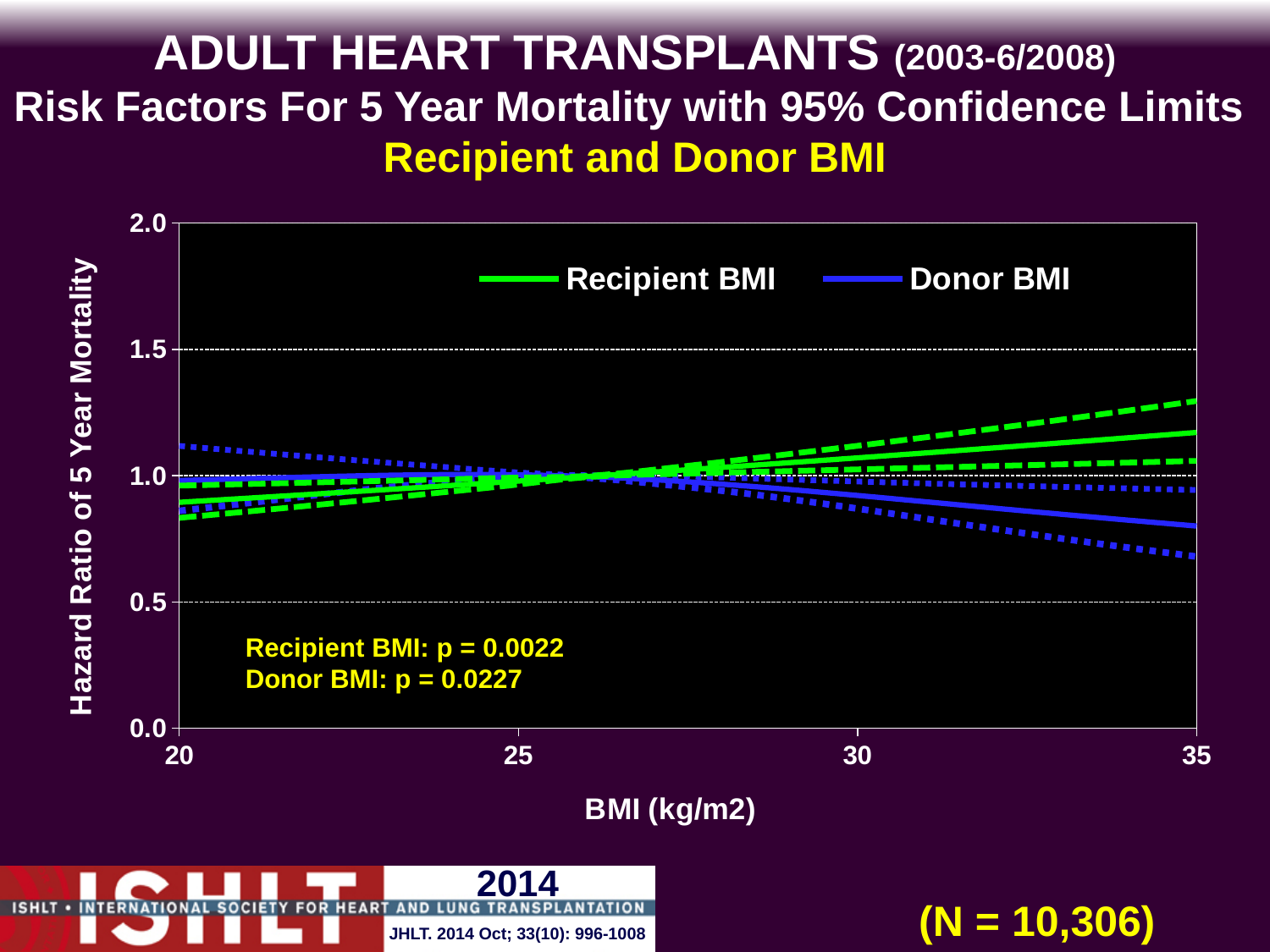
What p-value is shown for Recipient BMI? p = 0.0022 At a BMI of 35, is the lower confidence limit for Donor BMI greater or less than 0.5? greater At a BMI of 35, is the hazard ratio for Donor BMI greater or less than 1.0? less What kind of chart is shown on the slide? line chart Which colour represents Donor BMI in the legend? blue At a BMI of 35, is the hazard ratio for Recipient BMI greater or less than 1.0? greater How many series does the legend list? 2 At a BMI of 35, which series has the higher hazard ratio, Recipient BMI or Donor BMI? Recipient BMI Does the hazard ratio for Recipient BMI rise or fall as BMI increases from 20 to 35? rise Does the hazard ratio for Donor BMI rise or fall as BMI increases from 20 to 35? fall